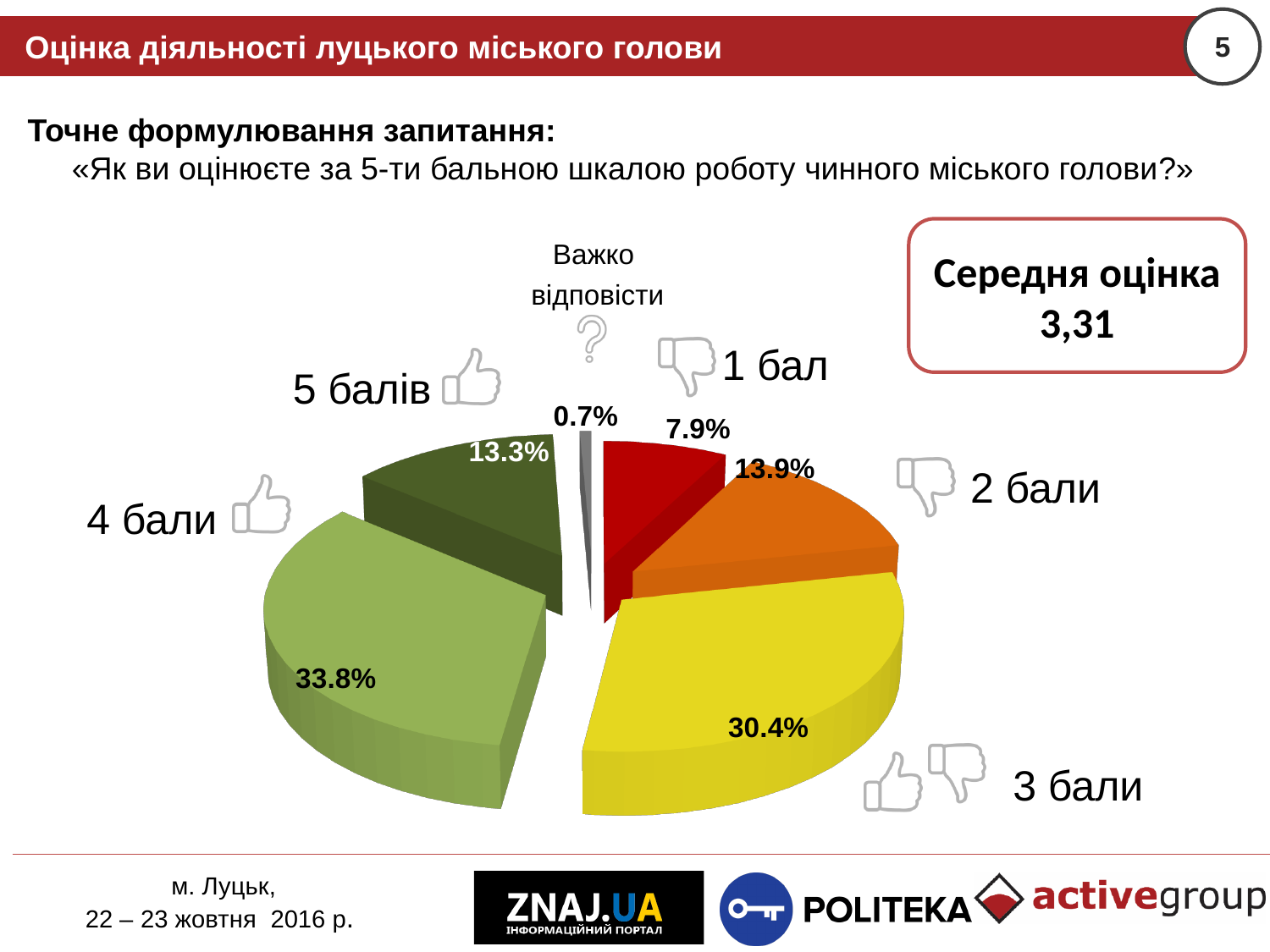
What share of respondents gave a score of 3 бали? 30.4% What is the difference between the shares for 4 бали and 3 бали? 3.4% What is the combined share of respondents who gave 1 бал or 2 бали? 21.8% Which category has the largest share of the pie? 4 бали How many slices does the pie chart have? 6 What share of respondents gave a score of 4 бали? 33.8% What kind of chart is shown on the slide? pie chart What average score (Середня оцінка) is shown on the slide? 3,31 What share of respondents gave a score of 1 бал? 7.9% What share of respondents answered «Важко відповісти»? 0.7% Which category has the smallest share of the pie? Важко відповісти Which is larger, the share for 2 бали or the share for 5 балів? 2 бали